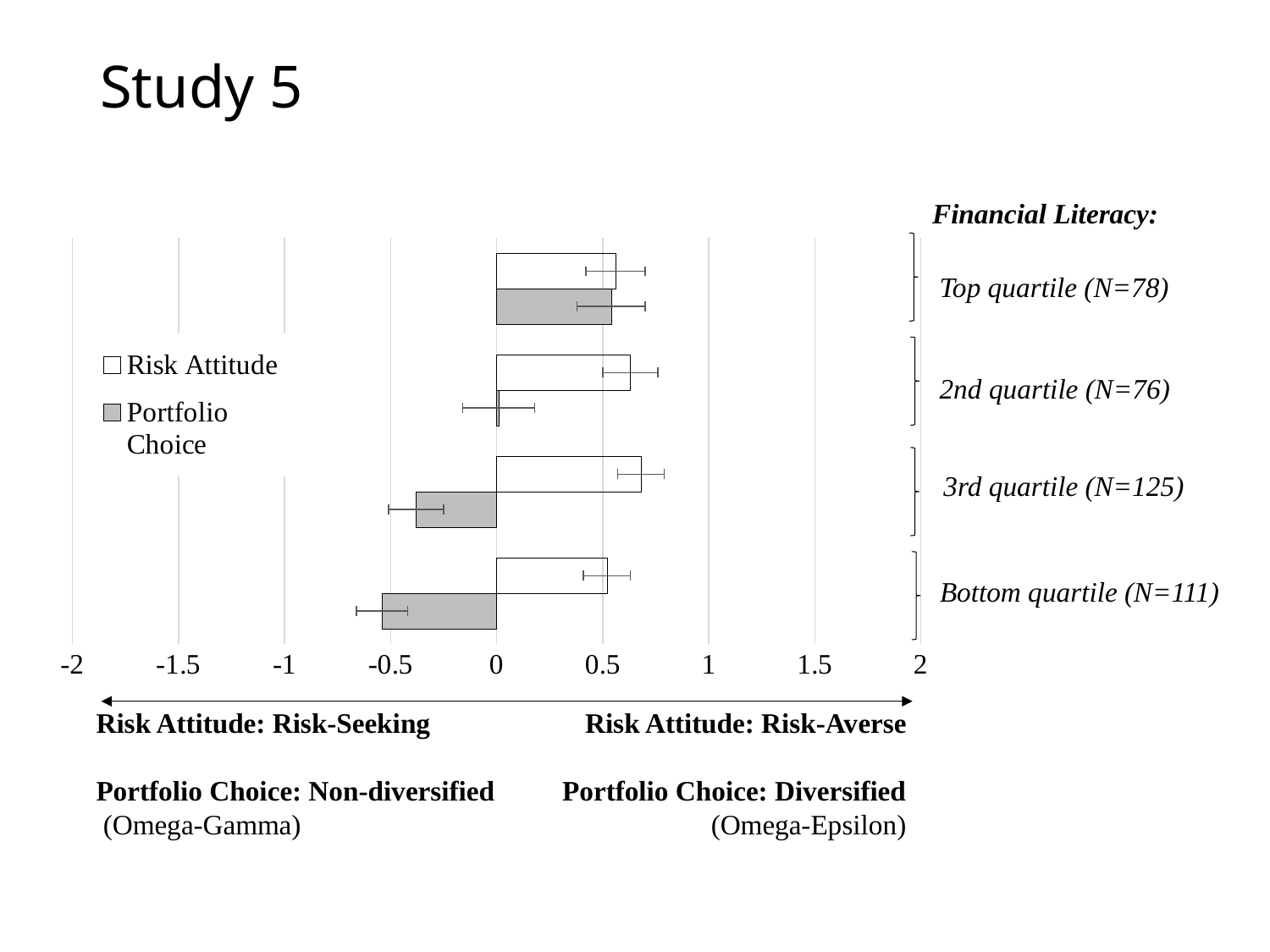
Do the Portfolio Choice values rise or fall going from the Top quartile down to the Bottom quartile? fall Is the Risk Attitude value for the Top quartile greater or less than 1? less How many series does the legend list? 2 What is the sample size shown for the 3rd quartile group? N=125 Is the Portfolio Choice value for the Top quartile greater or less than 0? greater Is the Portfolio Choice value for the 3rd quartile greater or less than 0? less Which is larger, the Portfolio Choice value for the Top quartile or for the Bottom quartile? Top quartile Which group has the lowest Portfolio Choice value? Bottom quartile (N=111) How many financial literacy quartile groups are plotted? 4 What kind of chart is shown on the slide? Bar chart What are the two series named in the legend? Risk Attitude and Portfolio Choice